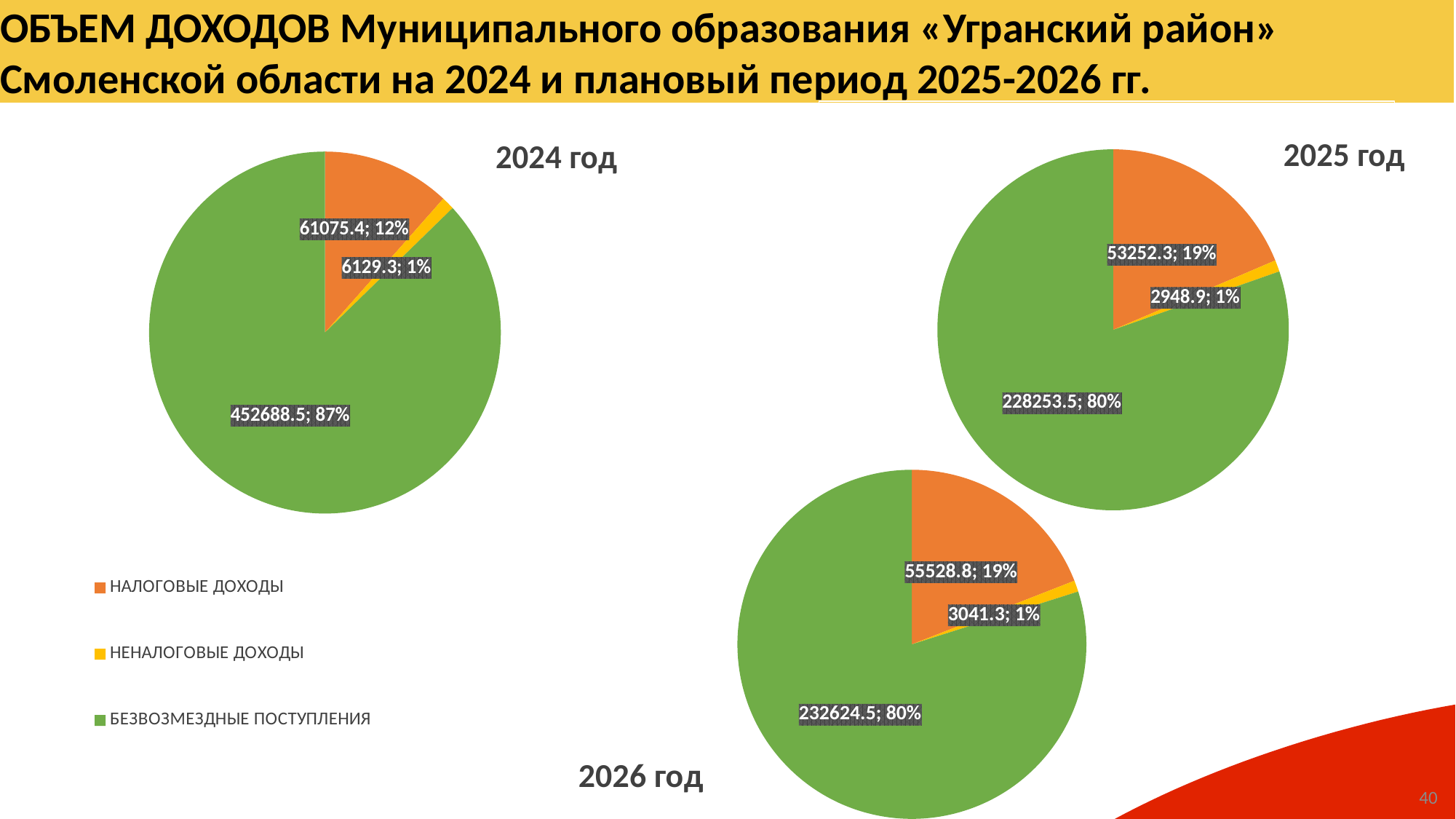
In the 2026 год pie chart, which category has the smallest slice? НЕНАЛОГОВЫЕ ДОХОДЫ Which is larger: НАЛОГОВЫЕ ДОХОДЫ in the 2025 год chart or НАЛОГОВЫЕ ДОХОДЫ in the 2026 год chart? 2026 год In the 2025 год pie chart, what share of the pie is НАЛОГОВЫЕ ДОХОДЫ? 19% In the 2026 год pie chart, what is the value for БЕЗВОЗМЕЗДНЫЕ ПОСТУПЛЕНИЯ? 232624.5 In the 2025 год pie chart, what is the value for НЕНАЛОГОВЫЕ ДОХОДЫ? 2948.9 In the 2024 год pie chart, which category has the largest slice? БЕЗВОЗМЕЗДНЫЕ ПОСТУПЛЕНИЯ In the 2024 год pie chart, what share of the pie is БЕЗВОЗМЕЗДНЫЕ ПОСТУПЛЕНИЯ? 87% In the 2024 год pie chart, what is the value for НАЛОГОВЫЕ ДОХОДЫ? 61075.4 How many slices does the 2025 год pie chart have? 3 What type of chart is used for 2024 год? Pie chart In the 2026 год pie chart, what is the difference between the values for НАЛОГОВЫЕ ДОХОДЫ and НЕНАЛОГОВЫЕ ДОХОДЫ? 52487.5 Which colour represents НЕНАЛОГОВЫЕ ДОХОДЫ in the legend? Yellow